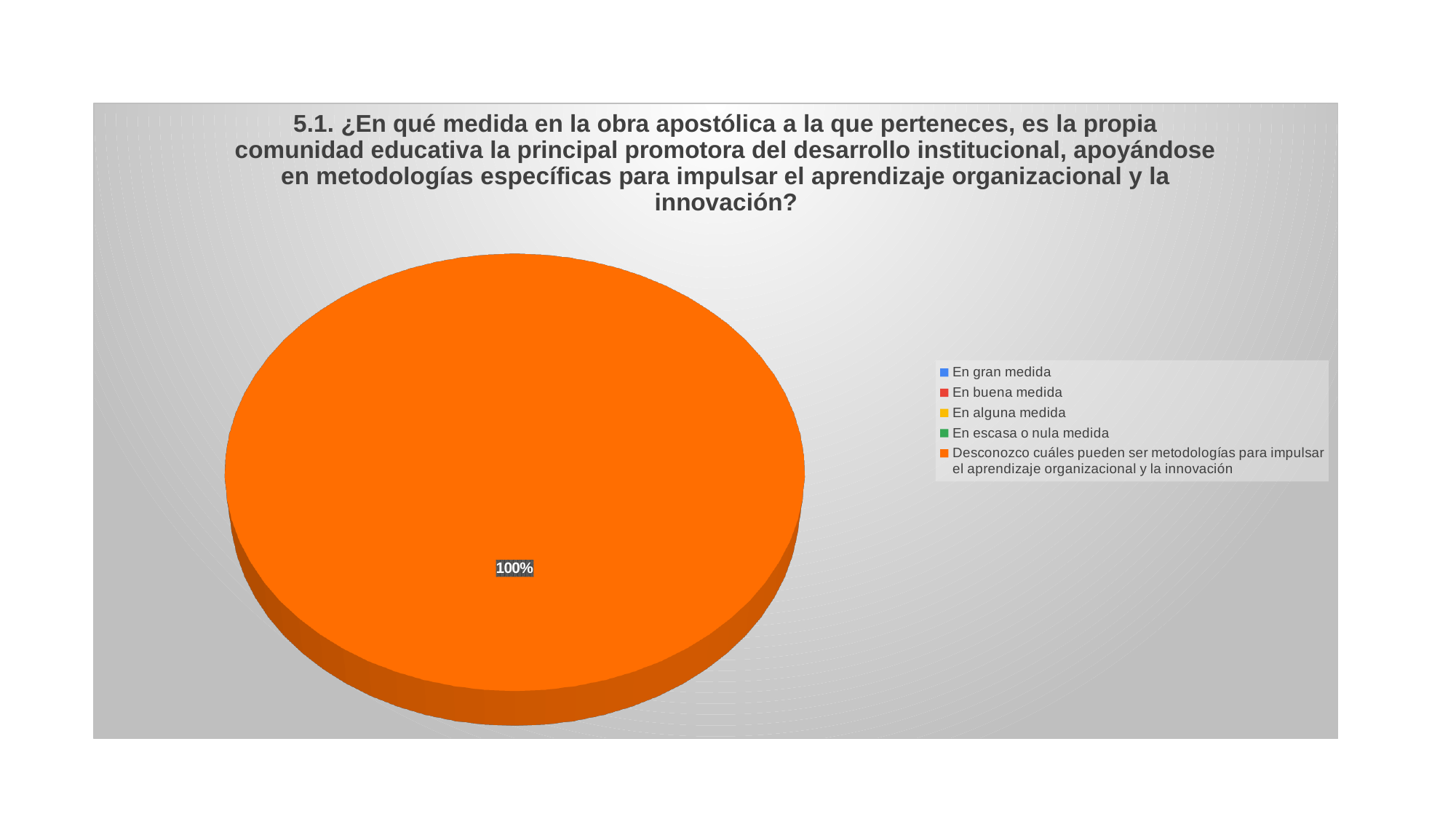
How many categories does the legend list? 5 Which legend entry is shown with a blue marker? En gran medida How many slices are visible in the pie? 1 Which category accounts for the largest share of the pie? Desconozco cuáles pueden ser metodologías para impulsar el aprendizaje organizacional y la innovación What colour is the slice that makes up the whole pie? orange Is the share for "Desconozco cuáles pueden ser metodologías para impulsar el aprendizaje organizacional y la innovación" greater or less than 50%? greater What share of the pie does the slice for "Desconozco cuáles pueden ser metodologías para impulsar el aprendizaje organizacional y la innovación" represent? 100% What value is printed on the only visible slice of the pie? 100% What kind of chart is shown on the slide? pie chart